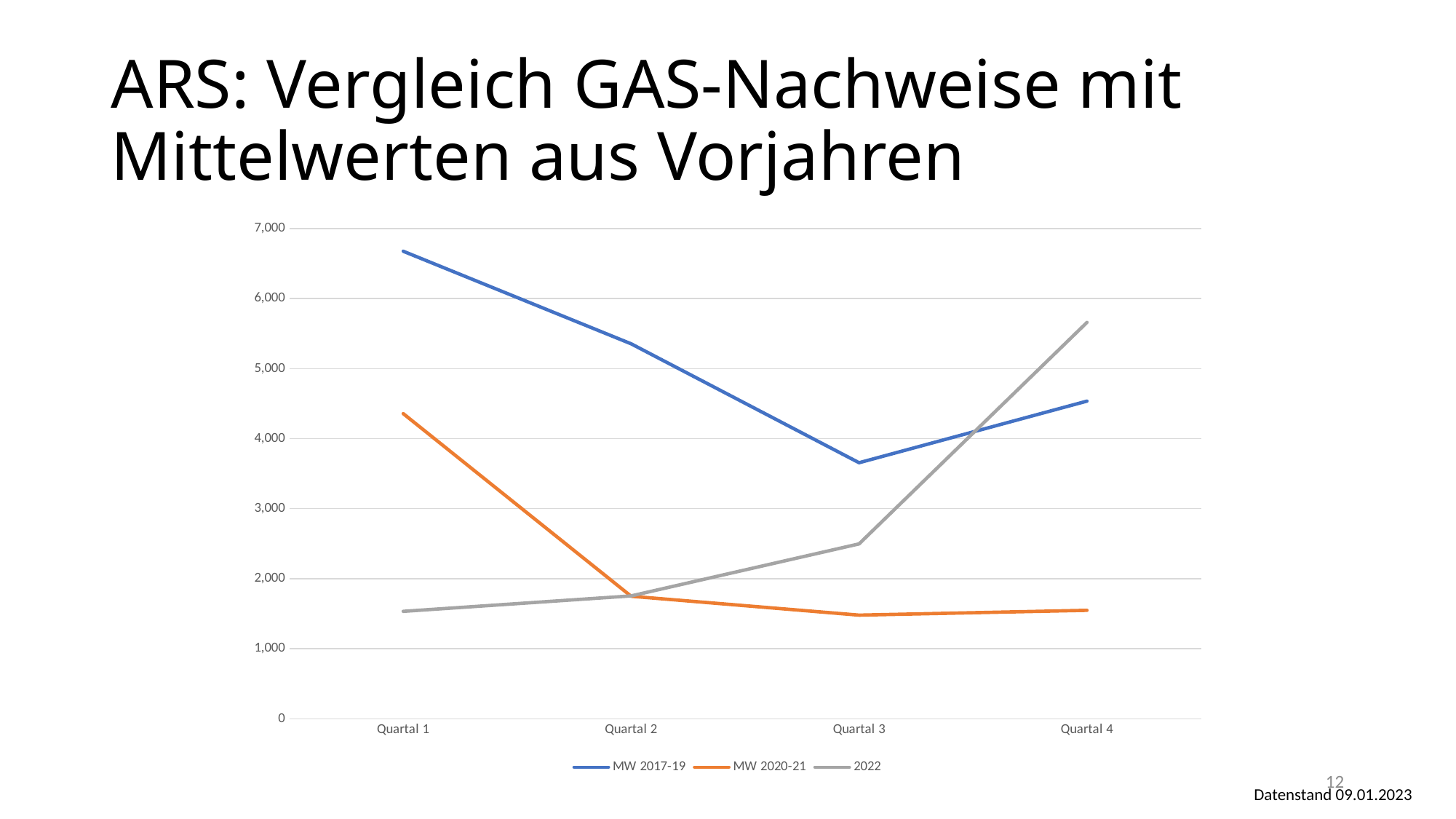
How many series does the legend list? 3 In which quarter is the 2022 series highest? Quartal 4 What kind of chart is shown on the slide? line chart Is the value for MW 2017-19 in Quartal 1 greater or less than 6,000? greater Does the 2022 series rise or fall from Quartal 1 to Quartal 4? rise What colour is the line for the 2022 series? gray Is the value for 2022 in Quartal 4 greater or less than 5,000? greater In which quarter is the MW 2017-19 series highest? Quartal 1 In which quarter is the MW 2017-19 series lowest? Quartal 3 How many quarters are shown on the x axis? 4 Is the value for MW 2020-21 in Quartal 3 greater or less than 2,000? less In Quartal 4, which series has the larger value: 2022 or MW 2017-19? 2022